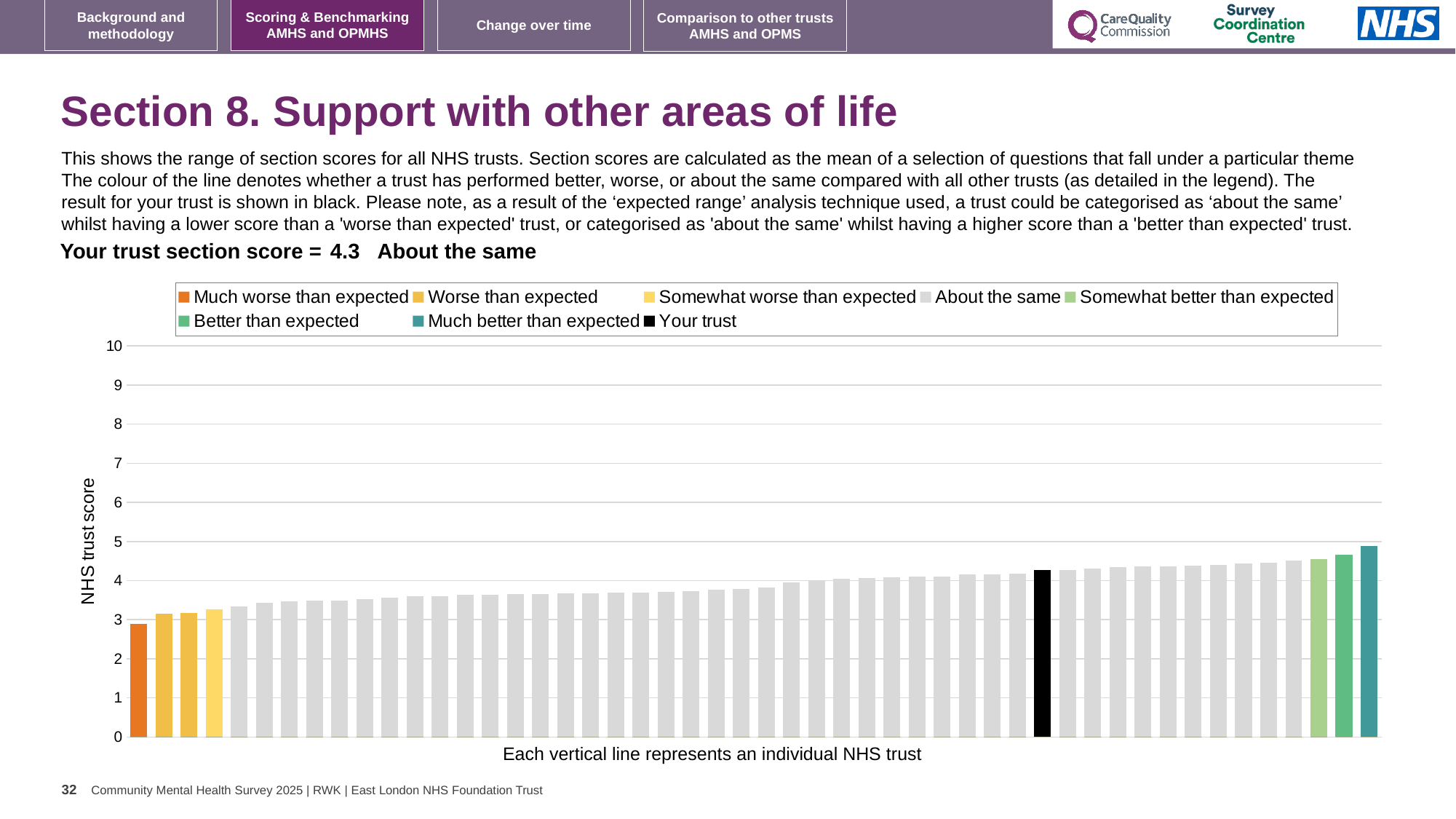
What is your trust's section score for Section 8, Support with other areas of life? 4.3 Which legend category does the shortest bar belong to? Much worse than expected Is the value for the tallest bar (the 'Much better than expected' trust) greater or less than 4? greater Which legend category does the tallest bar belong to? Much better than expected Is the value for your trust (the black bar) greater or less than 4? greater Do the bar values rise or fall from left to right along the x axis? Rise What is the label on the y axis of the chart? NHS trust score What kind of chart is shown on the slide? Bar chart How is your trust's section score categorised compared with other trusts? About the same How many entries does the chart legend list? 8 Is the value for the orange 'Much worse than expected' bar greater or less than 2? greater Which is taller: the black 'Your trust' bar or the orange 'Much worse than expected' bar? Your trust